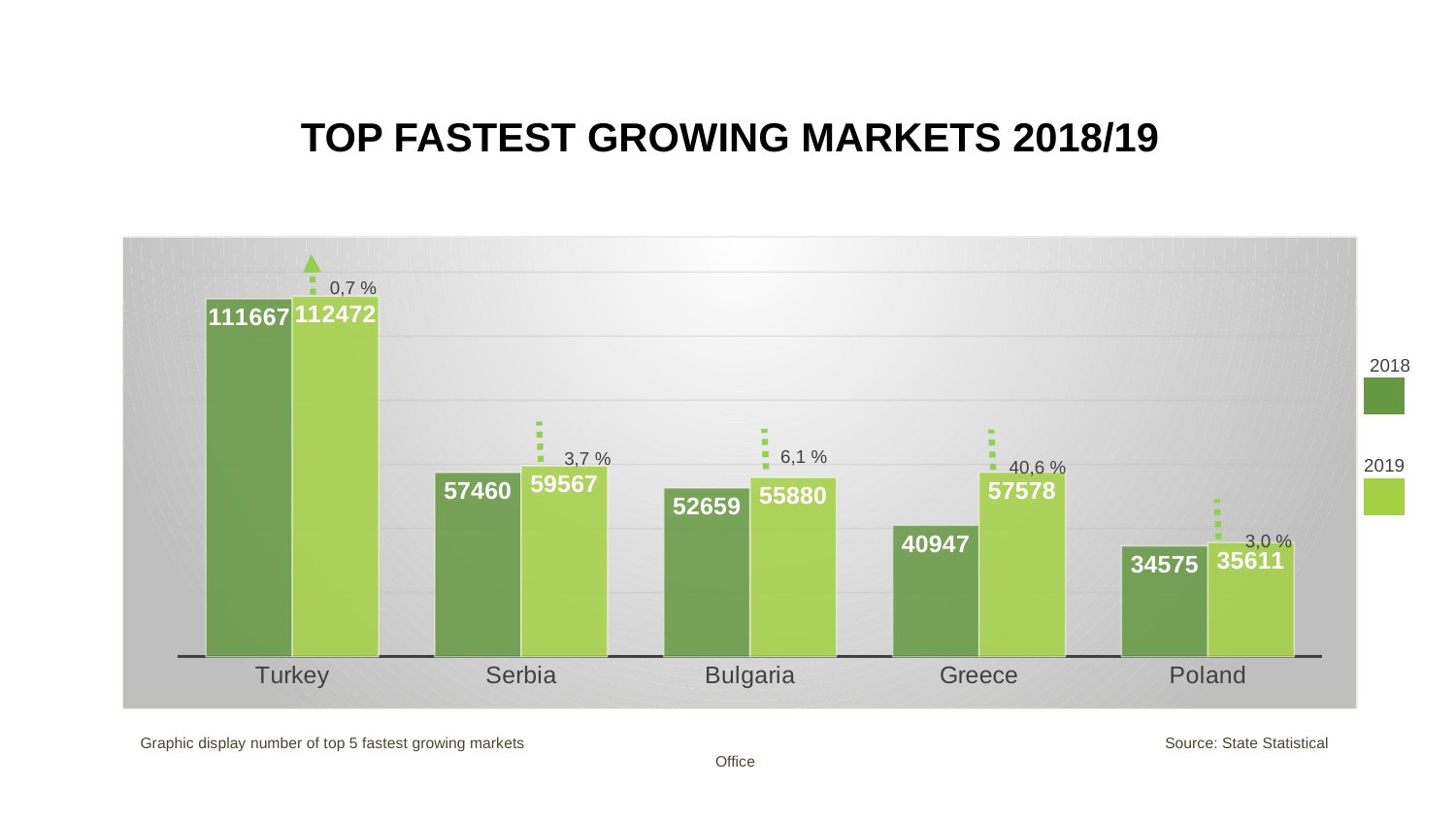
Which is larger: Bulgaria's 2019 value or Greece's 2019 value? Greece's 2019 value What was the value for Bulgaria in 2019? 55880 What is the difference between Serbia's 2019 and 2018 values? 2107 How many series does the legend list? 2 What was the value for Greece in 2018? 40947 Which country has the highest value in 2019? Turkey Which country has the lowest value in 2018? Poland What is the title of the chart? TOP FASTEST GROWING MARKETS 2018/19 What was the value for Turkey in 2019? 112472 What kind of chart is shown on the slide? Bar chart How many countries are shown on the chart? 5 What growth percentage is shown above the Greece bars? 40,6 %